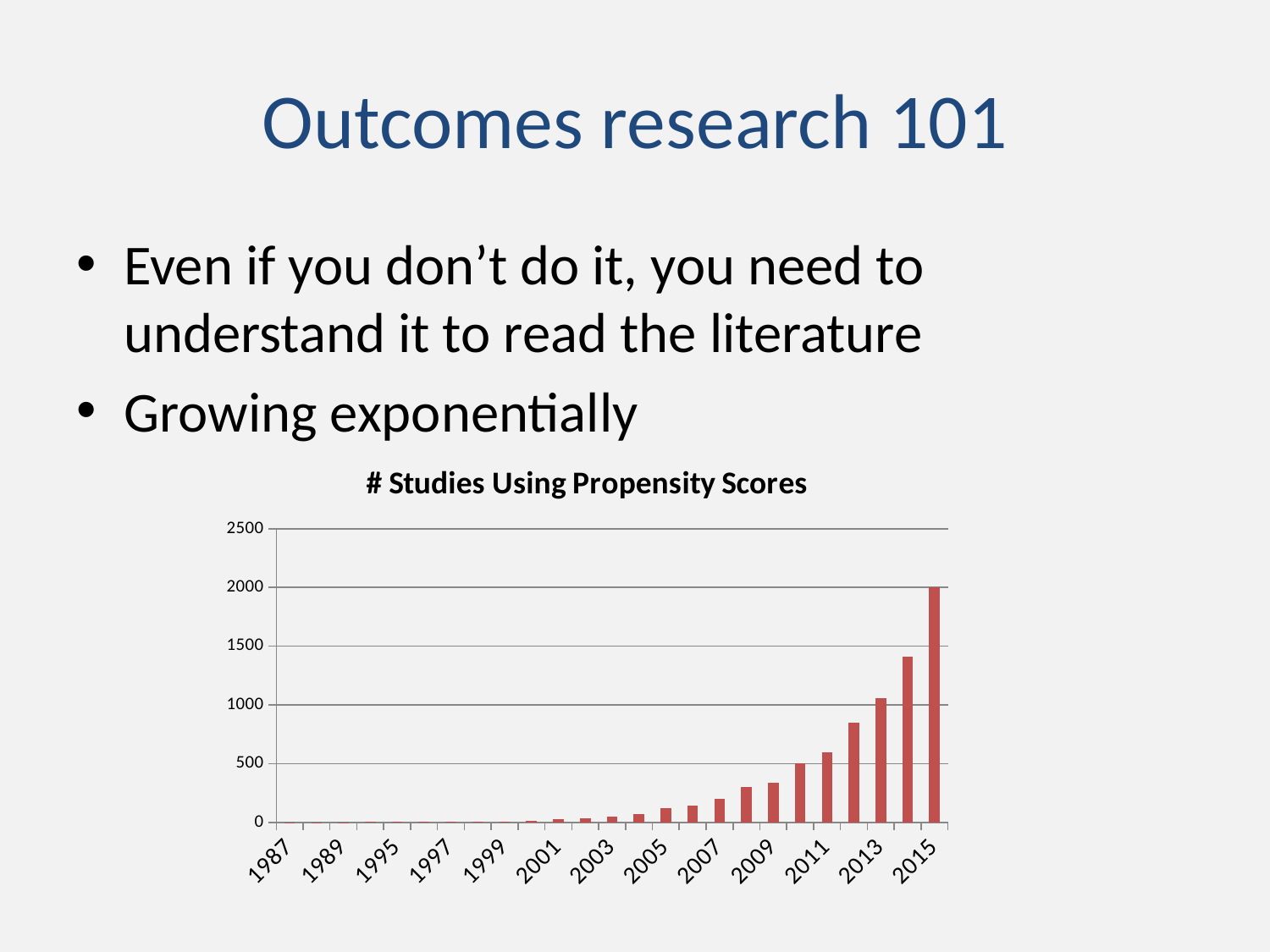
Do the values generally rise or fall from 1987 to 2015? rise Is the value for 2015 greater or less than 1500? greater What colour are the bars in the chart? red Is the value for 2007 greater or less than 500? less What kind of chart is shown on the slide? bar chart Which year has the larger value, 2011 or 2013? 2013 What is the title of the chart? # Studies Using Propensity Scores Is the value for 2011 greater or less than 500? greater Which year has the highest number of studies using propensity scores? 2015